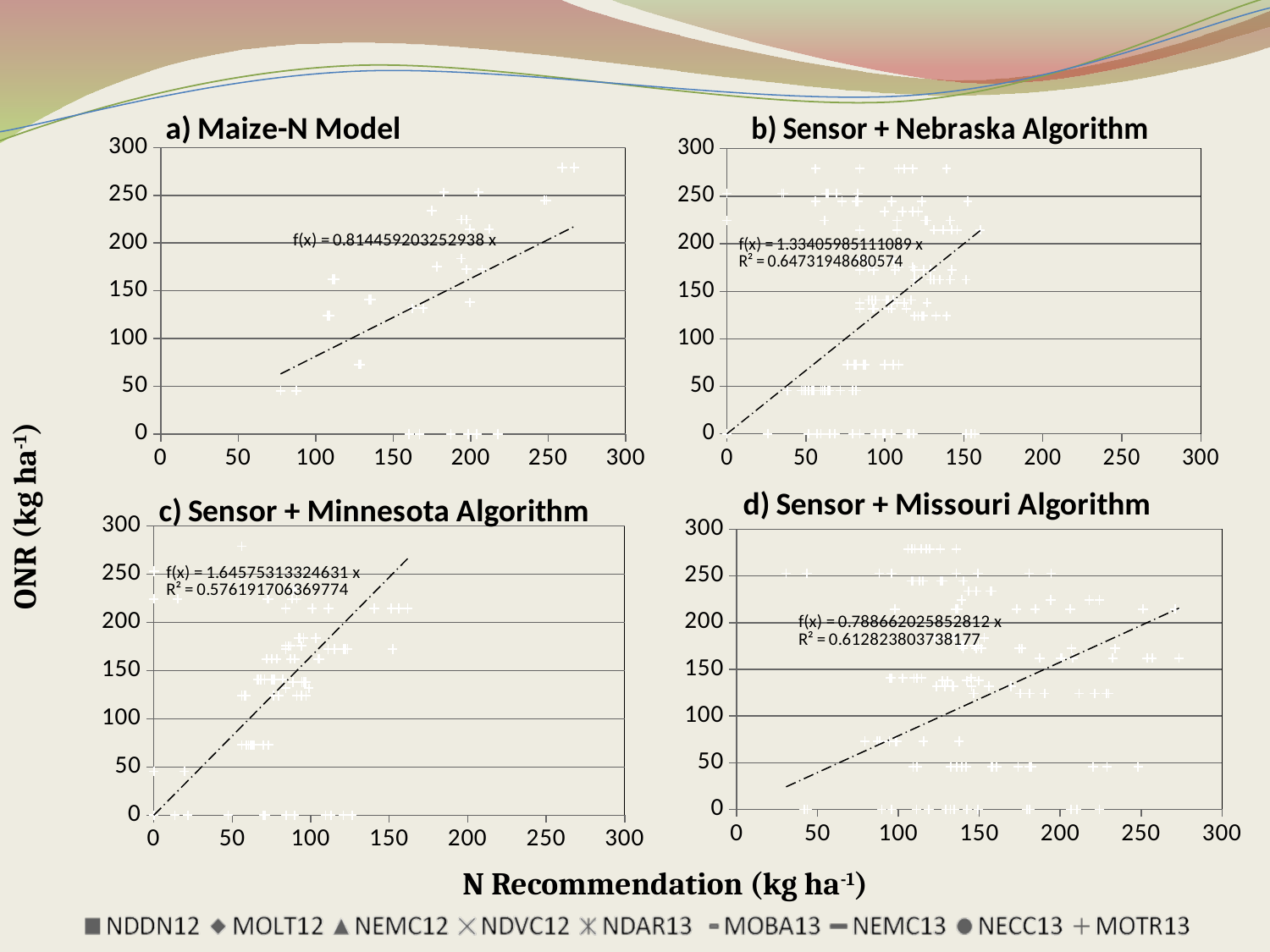
In the chart c) Sensor + Minnesota Algorithm, what R² value is printed? R² = 0.576191706369774 What is the maximum value shown on the y axis of the chart a) Maize-N Model? 300 In the chart b) Sensor + Nebraska Algorithm, what R² value is printed? R² = 0.64731948680574 In the chart d) Sensor + Missouri Algorithm, what R² value is printed? R² = 0.612823803738177 How many series does the legend at the bottom of the slide list? 9 What is the title of the chart in the top-right position? b) Sensor + Nebraska Algorithm What kind of chart is shown in panel a) Maize-N Model? scatter chart How many charts are on the slide? 4 Which chart has the larger printed trendline slope, b) Sensor + Nebraska Algorithm or c) Sensor + Minnesota Algorithm? c) Sensor + Minnesota Algorithm In the chart a) Maize-N Model, what is the printed trendline equation? f(x) = 0.814459203252938 x What is the y-axis label shared by the charts? ONR (kg ha-1) In the chart d) Sensor + Missouri Algorithm, does the fitted trendline rise or fall as N Recommendation increases? rise